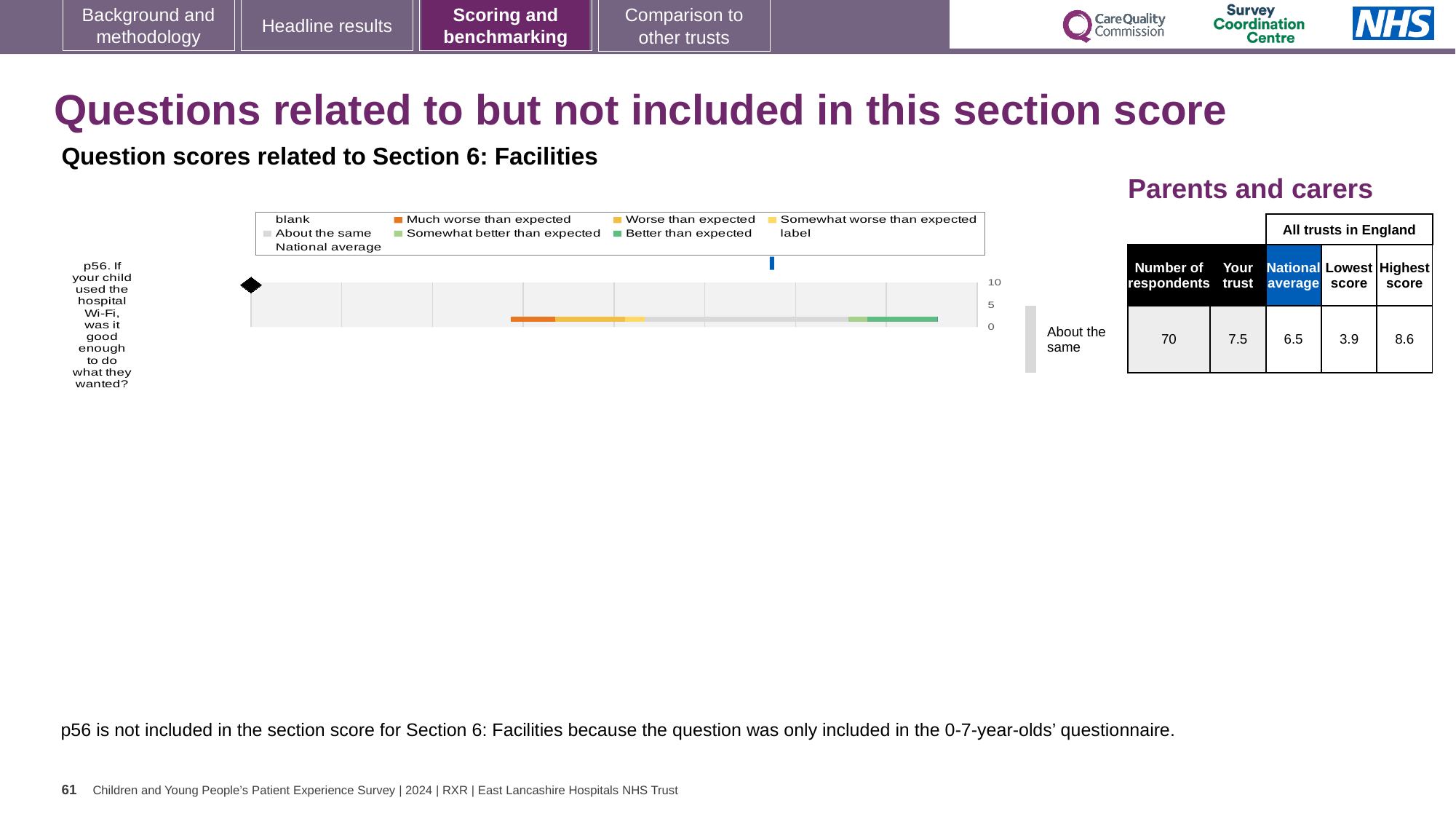
What is the difference between the 'Your trust' score and the national average for p56? 1.0 How many questions are plotted in the chart? 1 What is the maximum value shown on the chart's score axis? 10 What kind of chart is used to show the p56 question score? bar chart What is the difference between the highest and lowest scores for p56? 4.7 Which benchmark category is p56 placed in? About the same What is the 'Your trust' score for p56? 7.5 What is the national average score for p56? 6.5 What is the lowest score across all trusts in England for p56? 3.9 What is the highest score across all trusts in England for p56? 8.6 How many respondents answered p56? 70 Which is larger for p56, the 'Your trust' score or the national average? Your trust